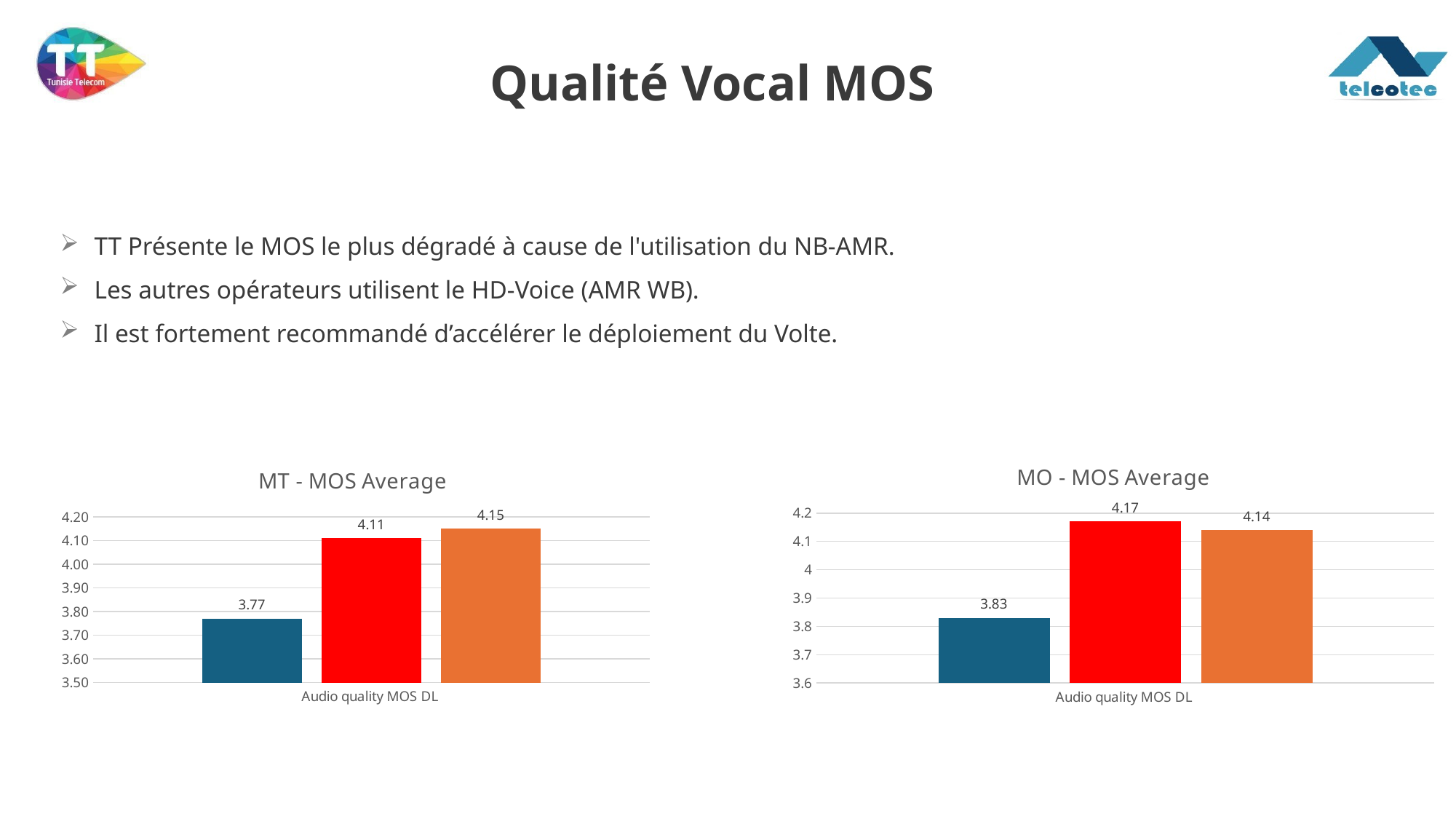
In the MO - MOS Average chart, what is the value of the blue bar? 3.83 In the MO - MOS Average chart, which is larger, the red bar or the blue bar? the red bar In the MT - MOS Average chart, which bar has the highest value? the orange bar (4.15) In the MT - MOS Average chart, what is the value of the red bar? 4.11 What kind of chart is the MT - MOS Average chart? bar chart How many bars are plotted in the MO - MOS Average chart? 3 In the MT - MOS Average chart, what is the difference between the orange bar and the blue bar? 0.38 In the MO - MOS Average chart, which bar has the lowest value? the blue bar (3.83) In the MT - MOS Average chart, is the value of the blue bar greater or less than 4.00? less In the MT - MOS Average chart, what is the value of the blue bar? 3.77 In the MO - MOS Average chart, what is the value of the orange bar? 4.14 In the MO - MOS Average chart, what is the difference between the red bar and the blue bar? 0.34